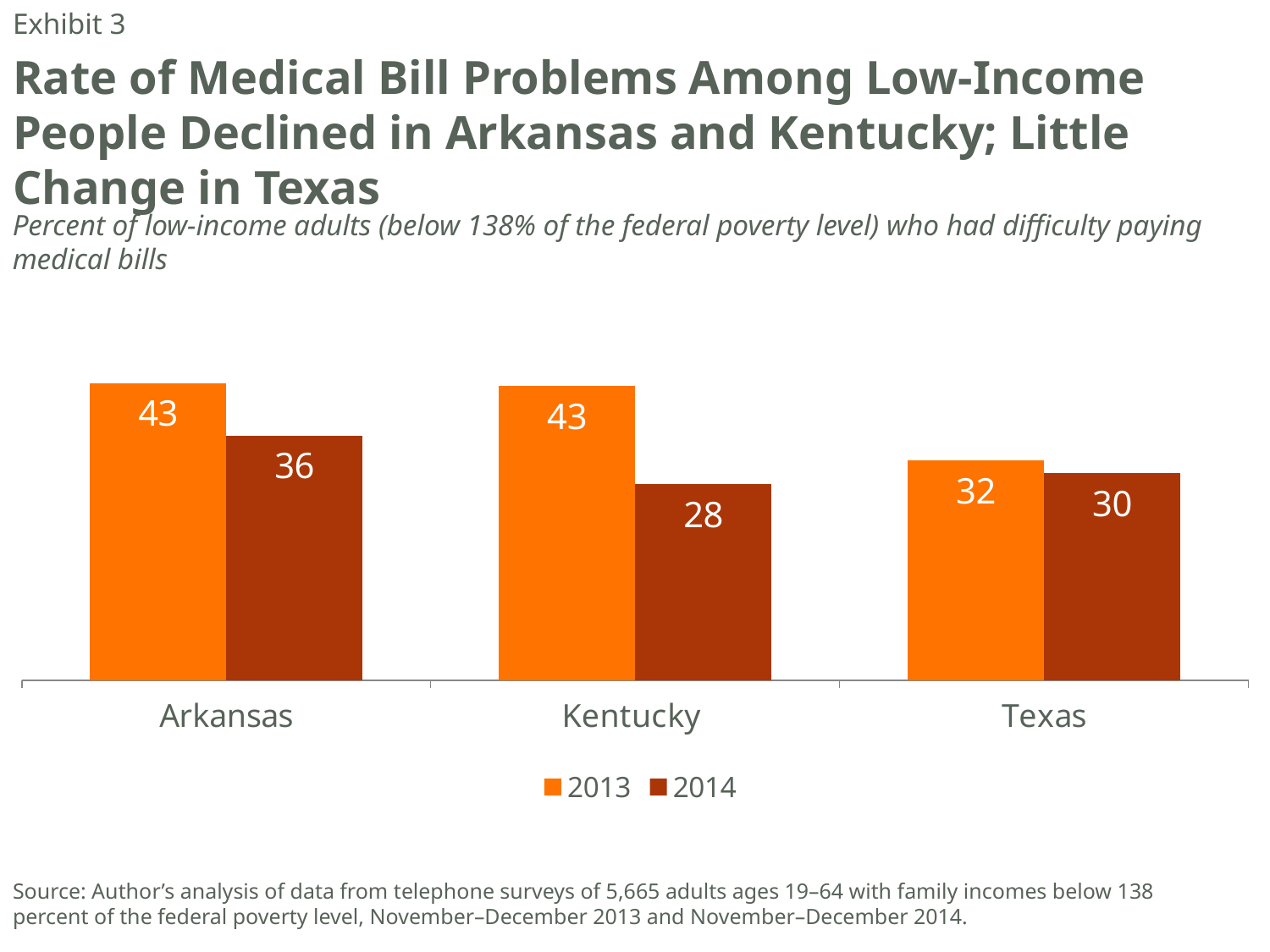
What was the value for Texas in 2013? 32 What is the difference between the 2013 and 2014 values for Arkansas? 7 By how much did the value for Kentucky fall from 2013 to 2014? 15 What was the value for Kentucky in 2014? 28 Which state had the lowest value in 2014? Kentucky Which state had the lowest value in 2013? Texas Which is larger: the 2014 value for Arkansas or the 2014 value for Texas? Arkansas What was the value for Texas in 2014? 30 How many states are shown on the x axis? 3 How many series does the legend list? 2 What was the value for Arkansas in 2013? 43 What kind of chart is shown on the slide? Bar chart